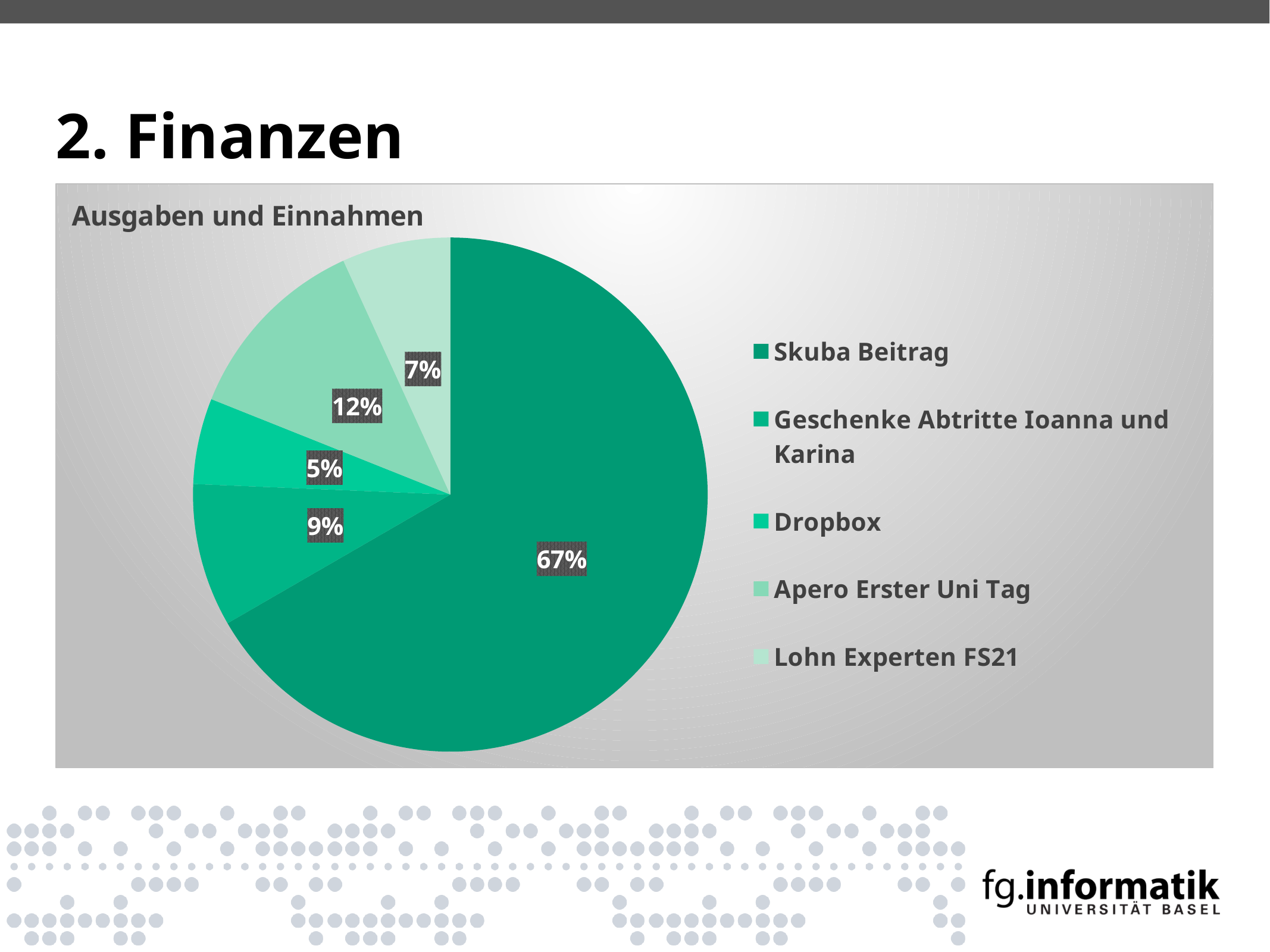
How many categories does the pie chart show? 5 What share of the pie does Apero Erster Uni Tag take? 12% What is the difference in percentage points between Apero Erster Uni Tag and Lohn Experten FS21? 5% What share of the pie does Dropbox take? 5% What share of the pie does Geschenke Abtritte Ioanna und Karina take? 9% What kind of chart is shown on the slide? pie chart Which category has the smallest slice of the pie? Dropbox Which category has the largest slice of the pie? Skuba Beitrag Which is larger, the share for Geschenke Abtritte Ioanna und Karina or the share for Dropbox? Geschenke Abtritte Ioanna und Karina What is the title of the chart? Ausgaben und Einnahmen